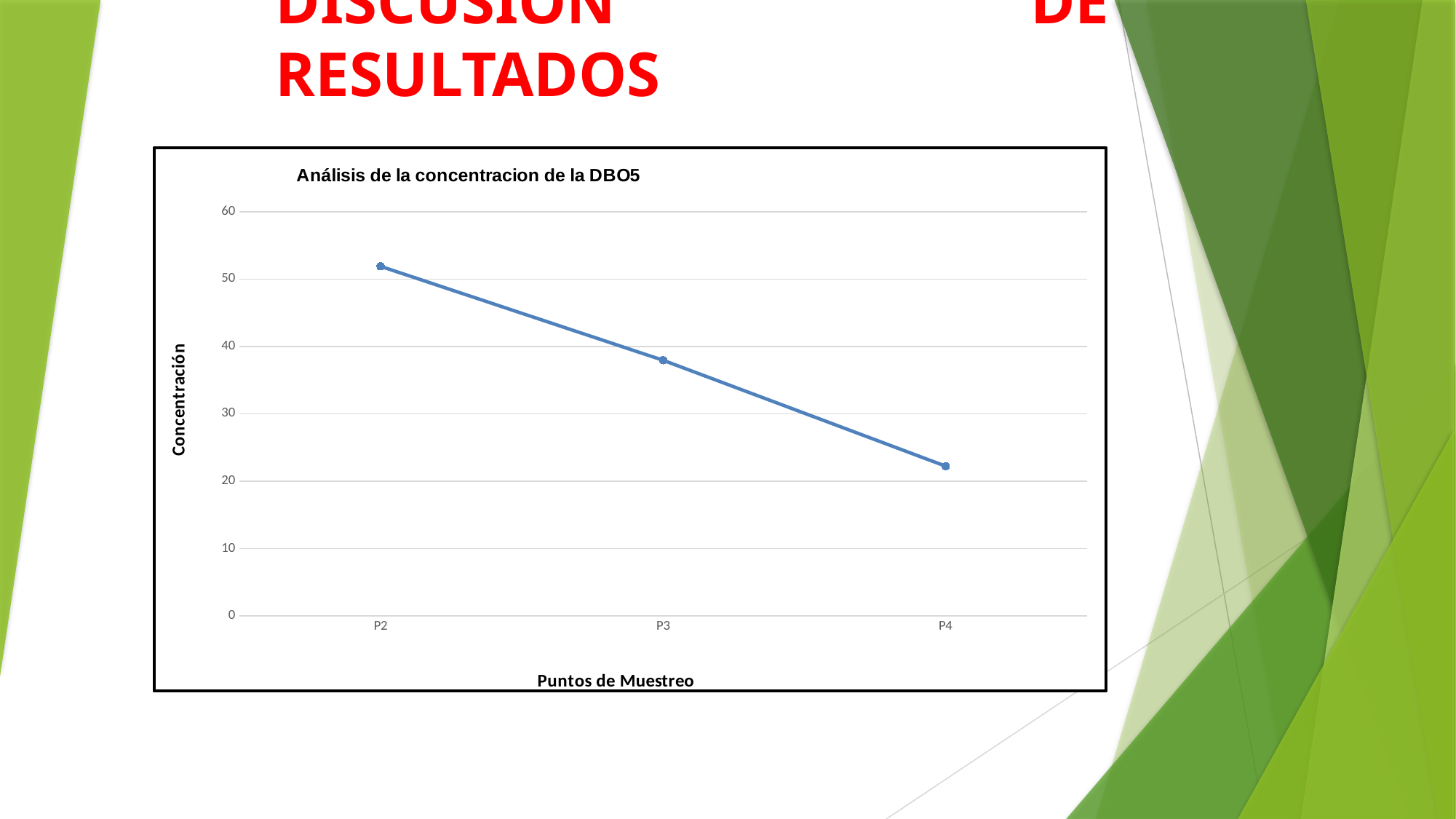
Which sampling point has the lowest concentration? P4 Which has a larger concentration, P3 or P4? P3 How many sampling points are plotted on the chart? 3 What kind of chart is shown on the slide? line chart What is the label of the x axis of the chart? Puntos de Muestreo Do the concentration values rise or fall from P2 to P4? fall What is the title of the chart? Análisis de la concentracion de la DBO5 Is the value for P4 greater or less than 30? less Is the value for P3 greater or less than 30? greater Which has a larger concentration, P2 or P3? P2 Is the value for P2 greater or less than 40? greater Which sampling point has the highest concentration? P2